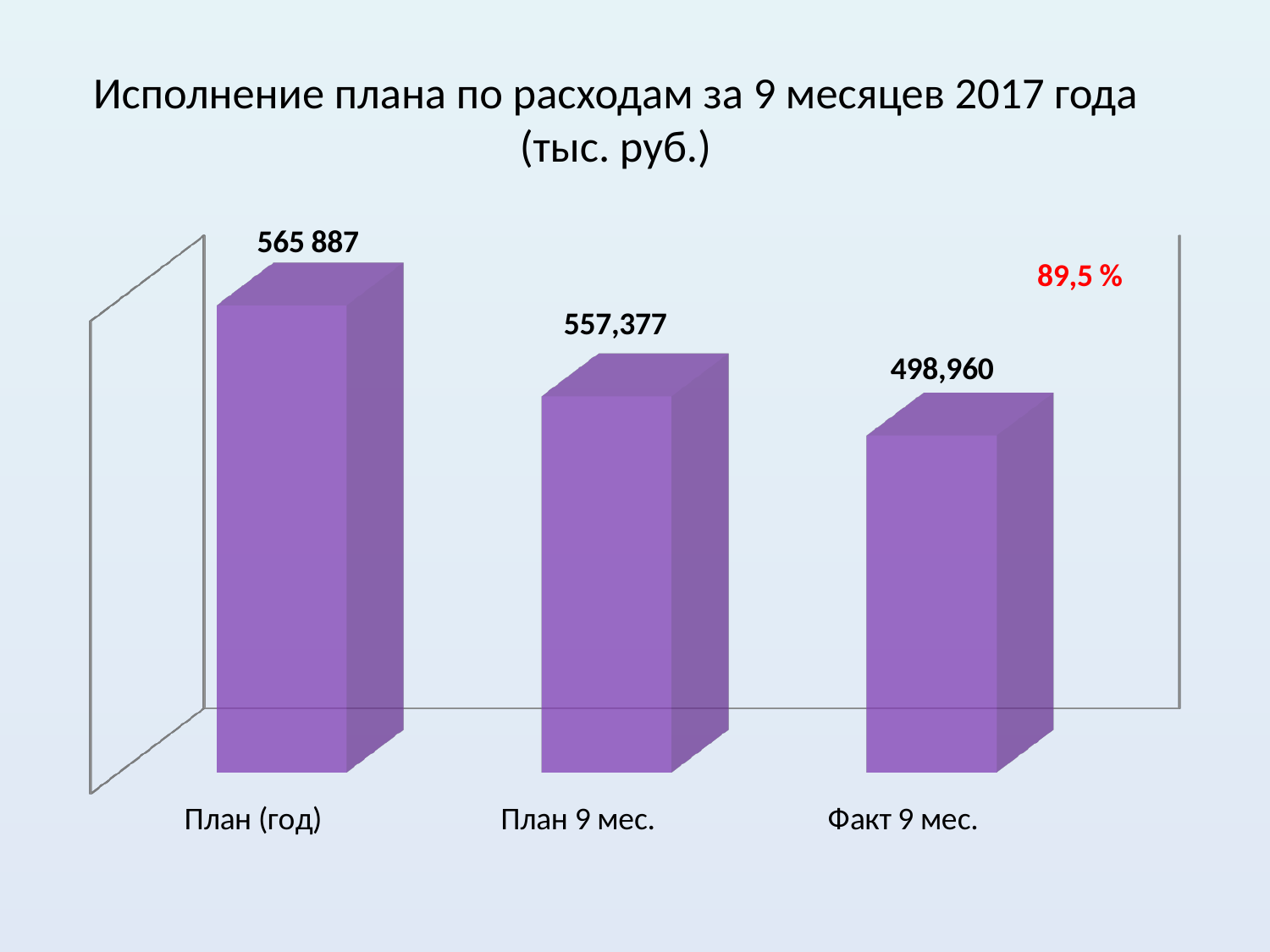
Do the values rise or fall from left to right across the categories? Fall What is the difference between the values for План 9 мес. and Факт 9 мес.? 58,417 Which category has the lowest value? Факт 9 мес. Which is larger, the value for План 9 мес. or the value for Факт 9 мес.? План 9 мес. What is the value for Факт 9 мес.? 498,960 What is the value for План (год)? 565 887 What kind of chart is shown on the slide? Bar chart What percentage is shown in red on the chart? 89,5 % What unit is given in the chart title? тыс. руб. How many categories are shown in the chart? 3 Which category has the highest value? План (год) What is the value for План 9 мес.? 557,377